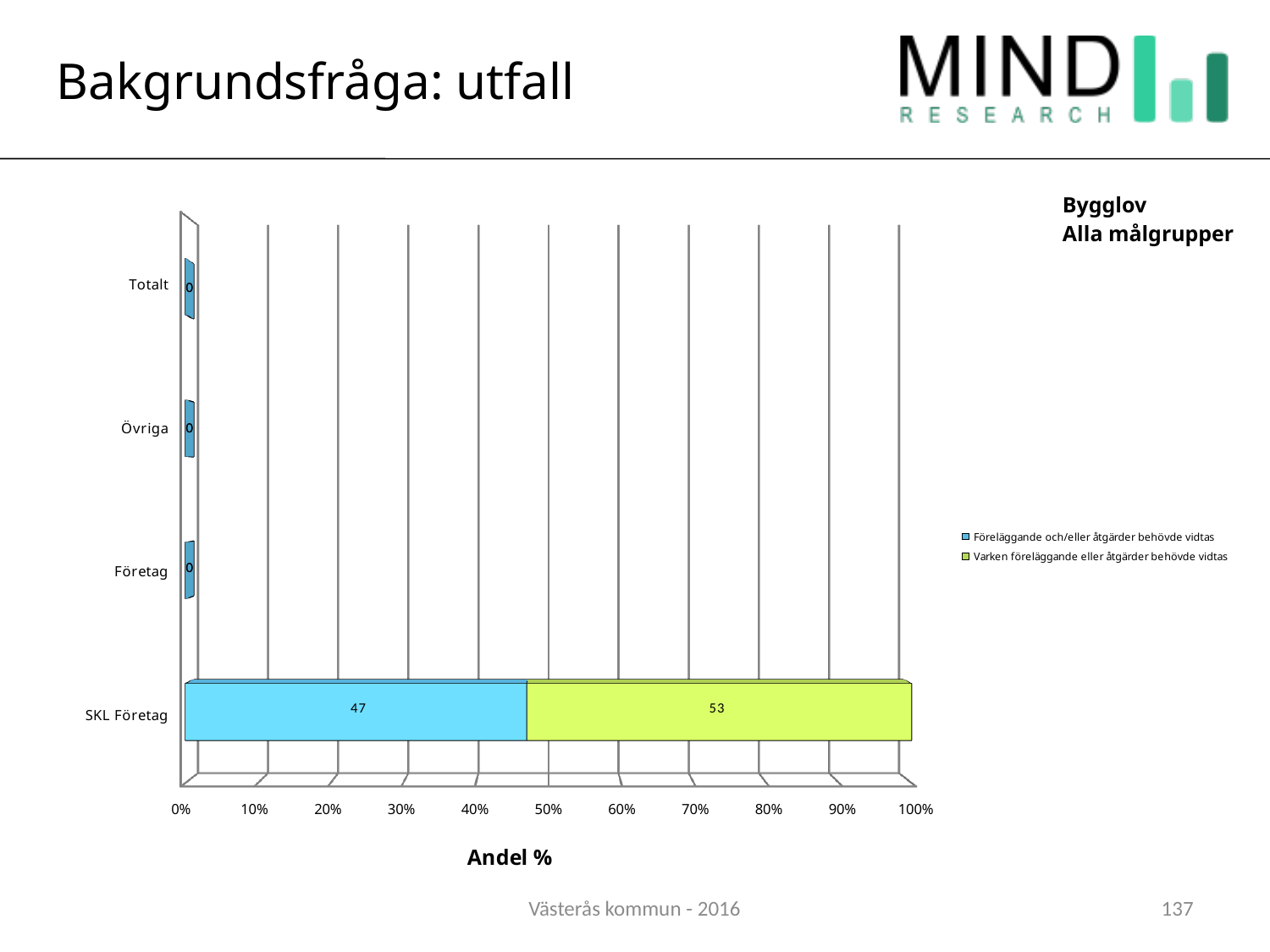
How many categories are shown on the vertical axis of the chart? 4 What is the value of 'Varken föreläggande eller åtgärder behövde vidtas' for SKL Företag? 53 What is the value of 'Föreläggande och/eller åtgärder behövde vidtas' for SKL Företag? 47 What is the value of 'Föreläggande och/eller åtgärder behövde vidtas' for Totalt? 0 What is the value of 'Föreläggande och/eller åtgärder behövde vidtas' for Företag? 0 What is the difference between the two values shown for SKL Företag? 6 What is the label of the horizontal axis of the chart? Andel % What kind of chart is shown on the slide? bar chart For SKL Företag, which is larger: 'Föreläggande och/eller åtgärder behövde vidtas' or 'Varken föreläggande eller åtgärder behövde vidtas'? Varken föreläggande eller åtgärder behövde vidtas What is the value of 'Föreläggande och/eller åtgärder behövde vidtas' for Övriga? 0 How many series does the chart legend list? 2 What is the total of the stacked bar for SKL Företag? 100